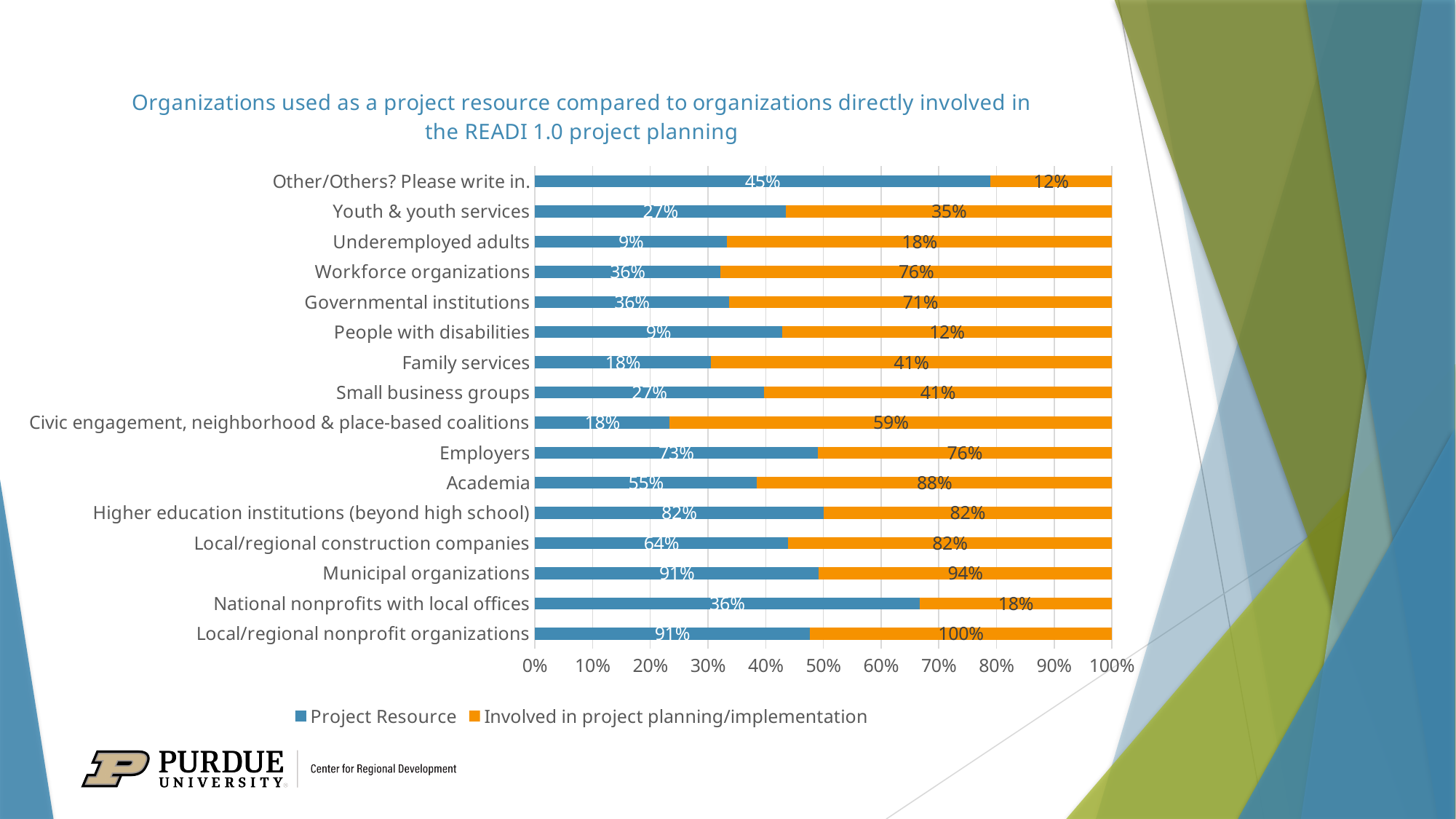
What is the Involved in project planning/implementation value for Municipal organizations? 94% Which has the larger Involved in project planning/implementation value: Workforce organizations or Governmental institutions? Workforce organizations What kind of chart is shown on the slide? Stacked bar chart Which has the larger Project Resource value: Local/regional construction companies or Higher education institutions (beyond high school)? Higher education institutions (beyond high school) How many series does the legend list? 2 What is the Involved in project planning/implementation value for Civic engagement, neighborhood & place-based coalitions? 59% What is the Project Resource value for Employers? 73% How many categories are shown on the chart? 16 What is the difference between the Involved in project planning/implementation value and the Project Resource value for Academia? 33 percentage points What is the Project Resource value for Academia? 55% What is the difference between the Project Resource value and the Involved in project planning/implementation value for National nonprofits with local offices? 18 percentage points Which category has the highest Involved in project planning/implementation value? Local/regional nonprofit organizations